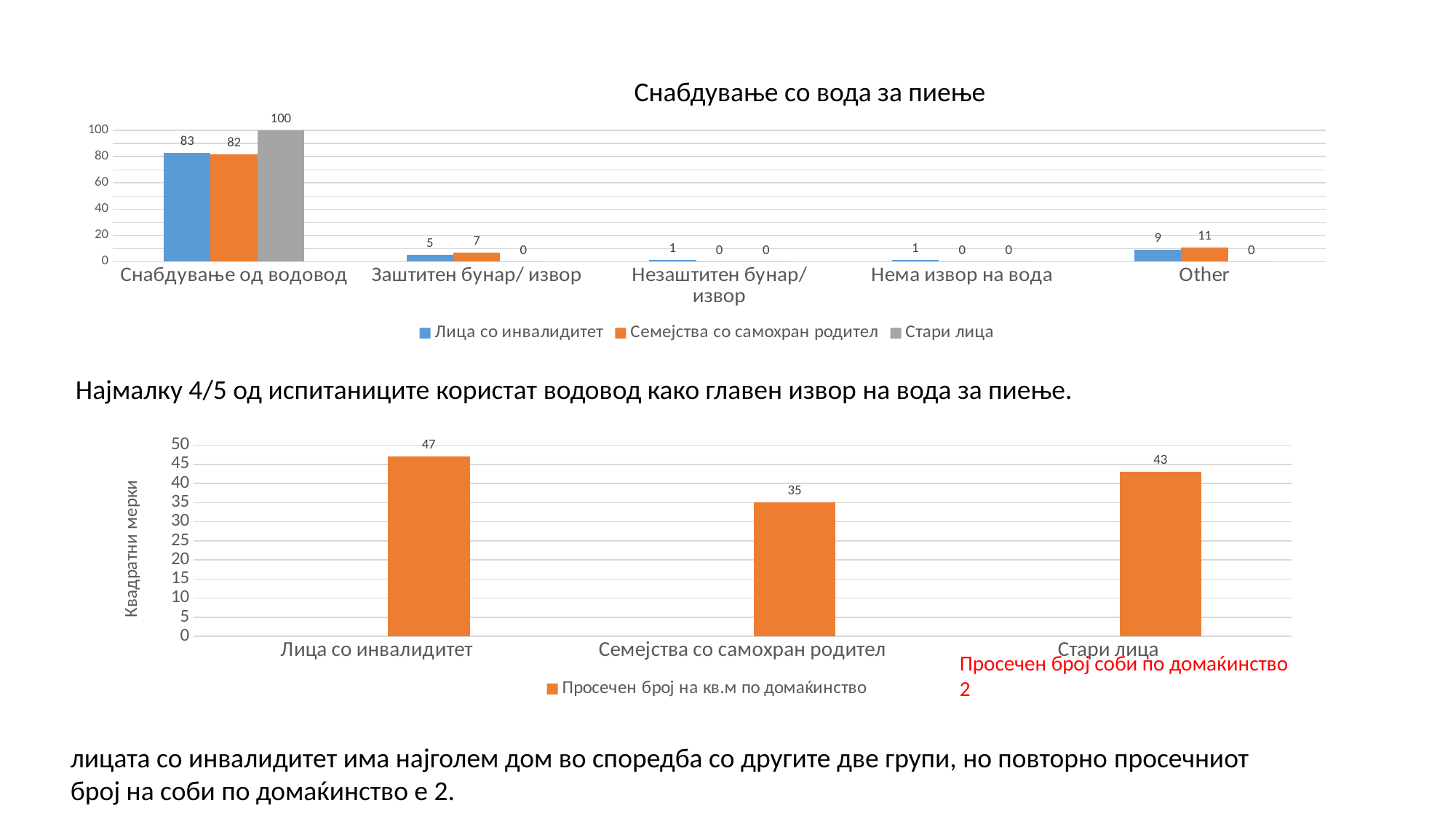
In the chart titled 'Снабдување со вода за пиење', how many categories are shown on the x axis? 5 In the bottom chart, what is the difference between 'Лица со инвалидитет' and 'Стари лица'? 4 In the bottom chart, which category has the highest value? Лица со инвалидитет In the chart titled 'Снабдување со вода за пиење', what is the difference between 'Лица со инвалидитет' and 'Семејства со самохран родител' in the 'Снабдување од водовод' category? 1 In the bottom chart, what is the value for 'Семејства со самохран родител'? 35 In the chart titled 'Снабдување со вода за пиење', which series is shown in grey? Стари лица In the chart titled 'Снабдување со вода за пиење', which category has the highest value for 'Стари лица'? Снабдување од водовод In the chart titled 'Снабдување со вода за пиење', what is the value for 'Лица со инвалидитет' in the 'Заштитен бунар/ извор' category? 5 In the chart titled 'Снабдување со вода за пиење', what is the value for 'Семејства со самохран родител' in the 'Other' category? 11 In the chart titled 'Снабдување со вода за пиење', what is the value for 'Стари лица' in the 'Снабдување од водовод' category? 100 What kind of chart is the bottom chart? Bar chart In the chart titled 'Снабдување со вода за пиење', how many series does the legend list? 3